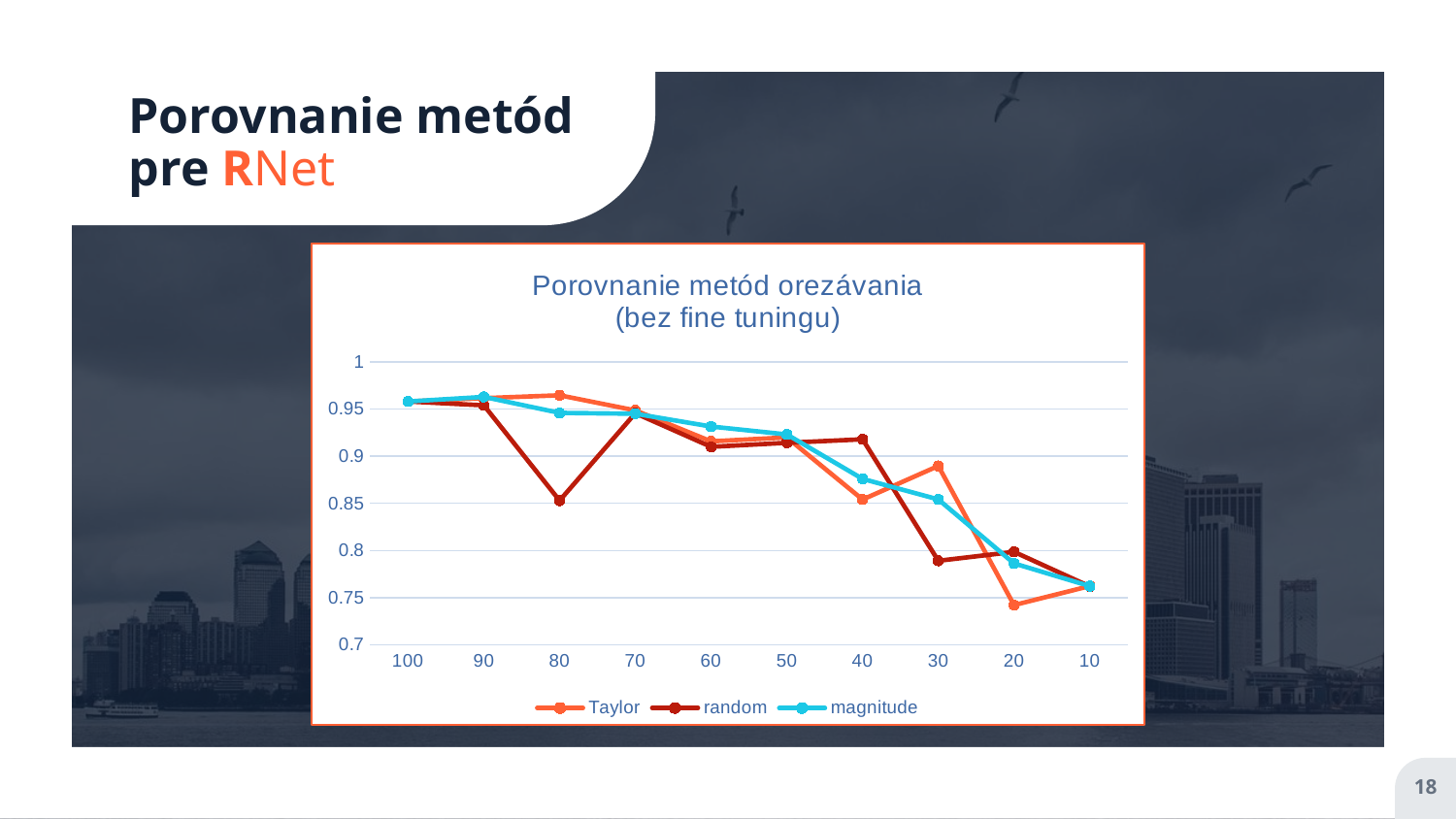
Do the values of the magnitude series rise or fall overall from 100 to 10 along the x axis? fall Is the value for the Taylor series at 20 greater or less than 0.75? less Is the value for the random series at 80 greater or less than 0.9? less Is the value for the Taylor series at 30 greater or less than 0.85? greater At x = 40, which series has the larger value, random or Taylor? random How many series does the legend list? 3 At x = 80, which series has the larger value, Taylor or random? Taylor What is the title of the chart? Porovnanie metód orezávania (bez fine tuningu) At x = 20, which series has the larger value, random or Taylor? random How many points are on the x axis of the chart? 10 What kind of chart is shown on the slide? line chart